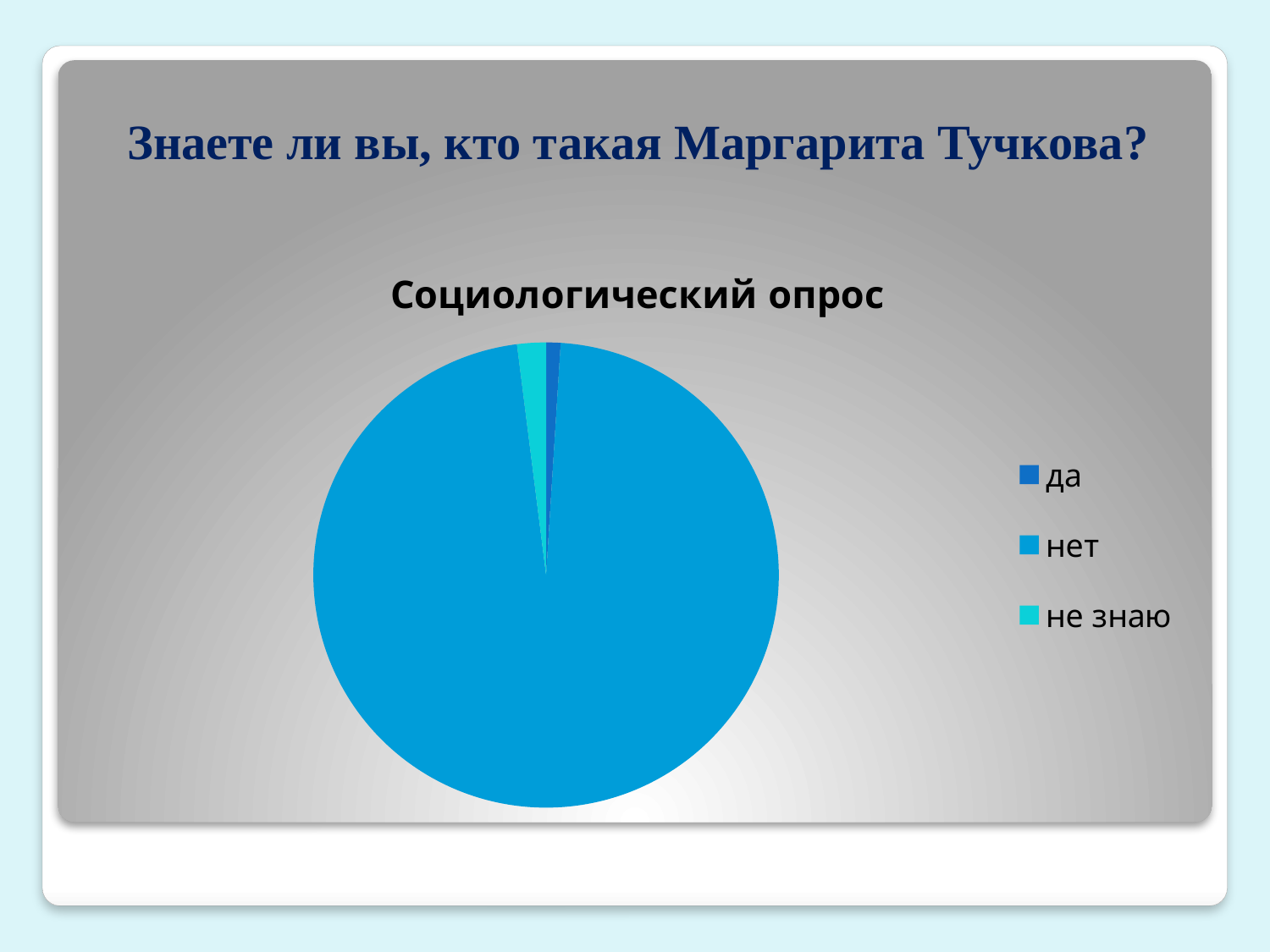
Which is larger, the slice for "нет" or the slice for "да"? нет What is the title of the chart? Социологический опрос How many entries does the legend list? 3 Which is larger, the slice for "нет" or the slice for "не знаю"? нет Which category has the largest slice of the pie? нет What kind of chart is shown on the slide? pie chart What are the three categories listed in the legend? да, нет, не знаю How many slices does the pie chart have? 3